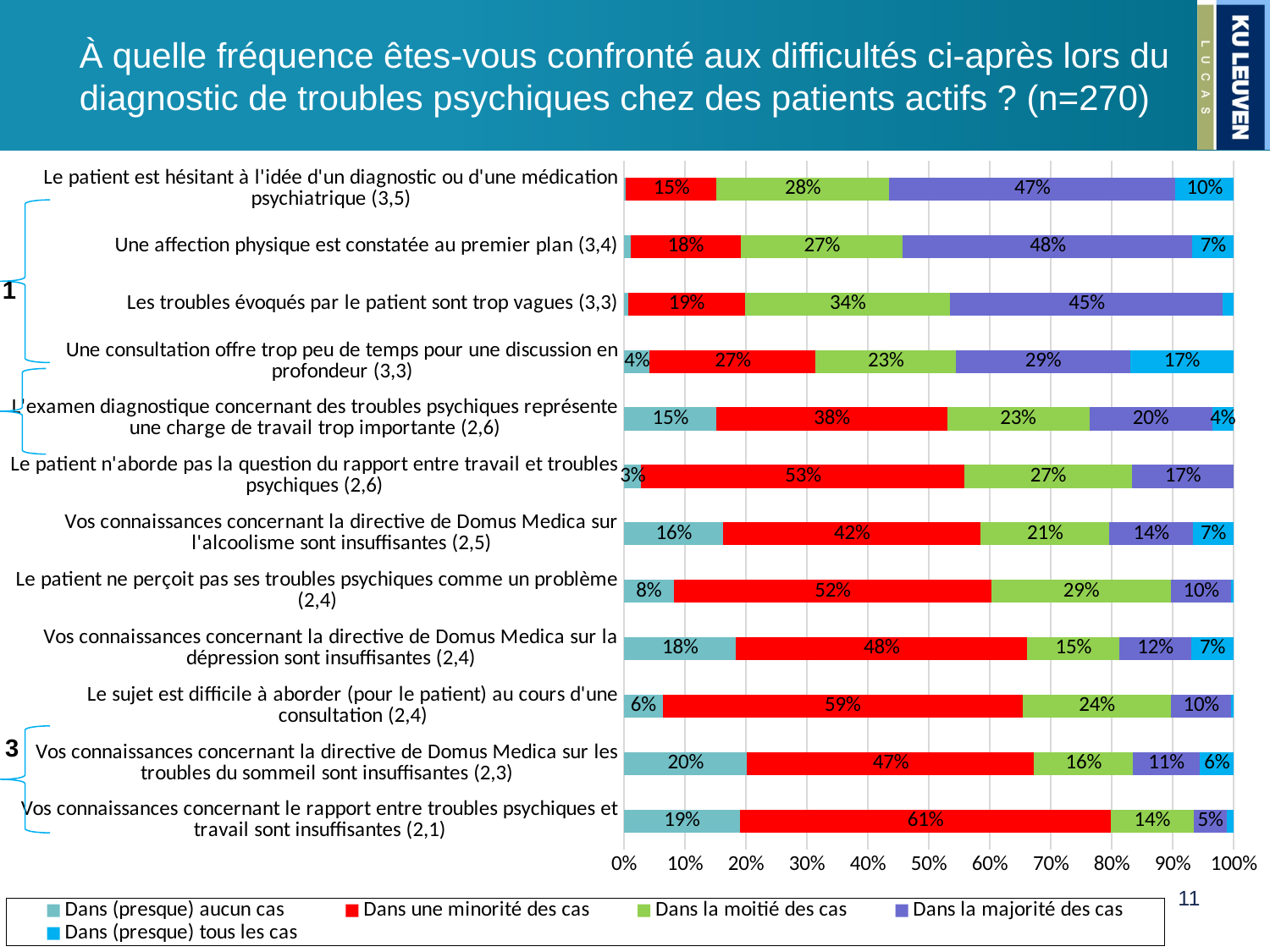
What is the value of "Dans (presque) tous les cas" for "Une consultation offre trop peu de temps pour une discussion en profondeur (3,3)"? 17% Which category has the highest value for "Dans la moitié des cas"? Les troubles évoqués par le patient sont trop vagues (3,3) What is the value of "Dans une minorité des cas" for "Vos connaissances concernant le rapport entre troubles psychiques et travail sont insuffisantes (2,1)"? 61% What is the value of "Dans la majorité des cas" for "Une affection physique est constatée au premier plan (3,4)"? 48% What is the value of "Dans (presque) aucun cas" for "Le patient ne perçoit pas ses troubles psychiques comme un problème (2,4)"? 8% What kind of chart is shown on the slide? Stacked bar chart What colour represents "Dans une minorité des cas" in the legend? Red How many series does the legend list? 5 Which has the larger "Dans (presque) aucun cas" value: the Domus Medica directive on troubles du sommeil (2,3) or the Domus Medica directive on dépression (2,4)? Troubles du sommeil (2,3) Which category has the highest value for "Dans une minorité des cas"? Vos connaissances concernant le rapport entre troubles psychiques et travail sont insuffisantes (2,1) How many categories (difficulties) are plotted on the chart? 12 What is the difference in "Dans une minorité des cas" between "Vos connaissances concernant le rapport entre troubles psychiques et travail sont insuffisantes (2,1)" and "Vos connaissances concernant la directive de Domus Medica sur les troubles du sommeil sont insuffisantes (2,3)"? 14 percentage points